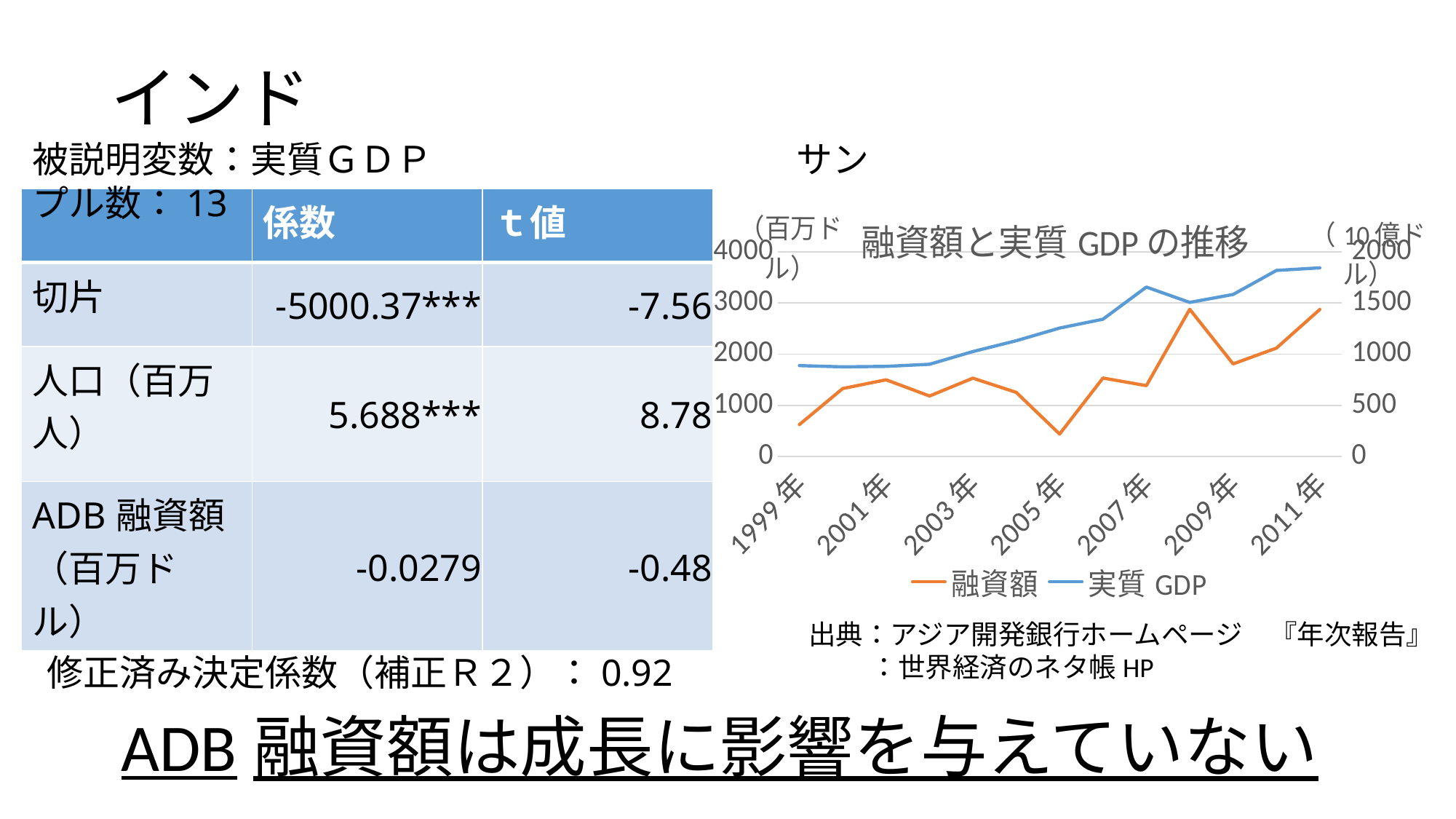
How many year labels are shown on the x axis of the chart? 7 Is the 実質 GDP value for 1999年 greater or less than 1000 on the right axis? less Is the 融資額 value for 2009年 greater or less than 2000 on the left axis? less Does the 実質 GDP series generally rise or fall from 1999年 to 2011年? rise In which year is the 実質 GDP series at its highest? 2011年 What is the title of the chart? 融資額と実質 GDP の推移 Is the 実質 GDP value for 2011年 greater or less than 1500 on the right axis? greater How many series does the legend of the chart list? 2 Which series is drawn in orange in the chart? 融資額 What kind of chart is shown on the slide? line chart In which year is the 融資額 series at its lowest? 2005年